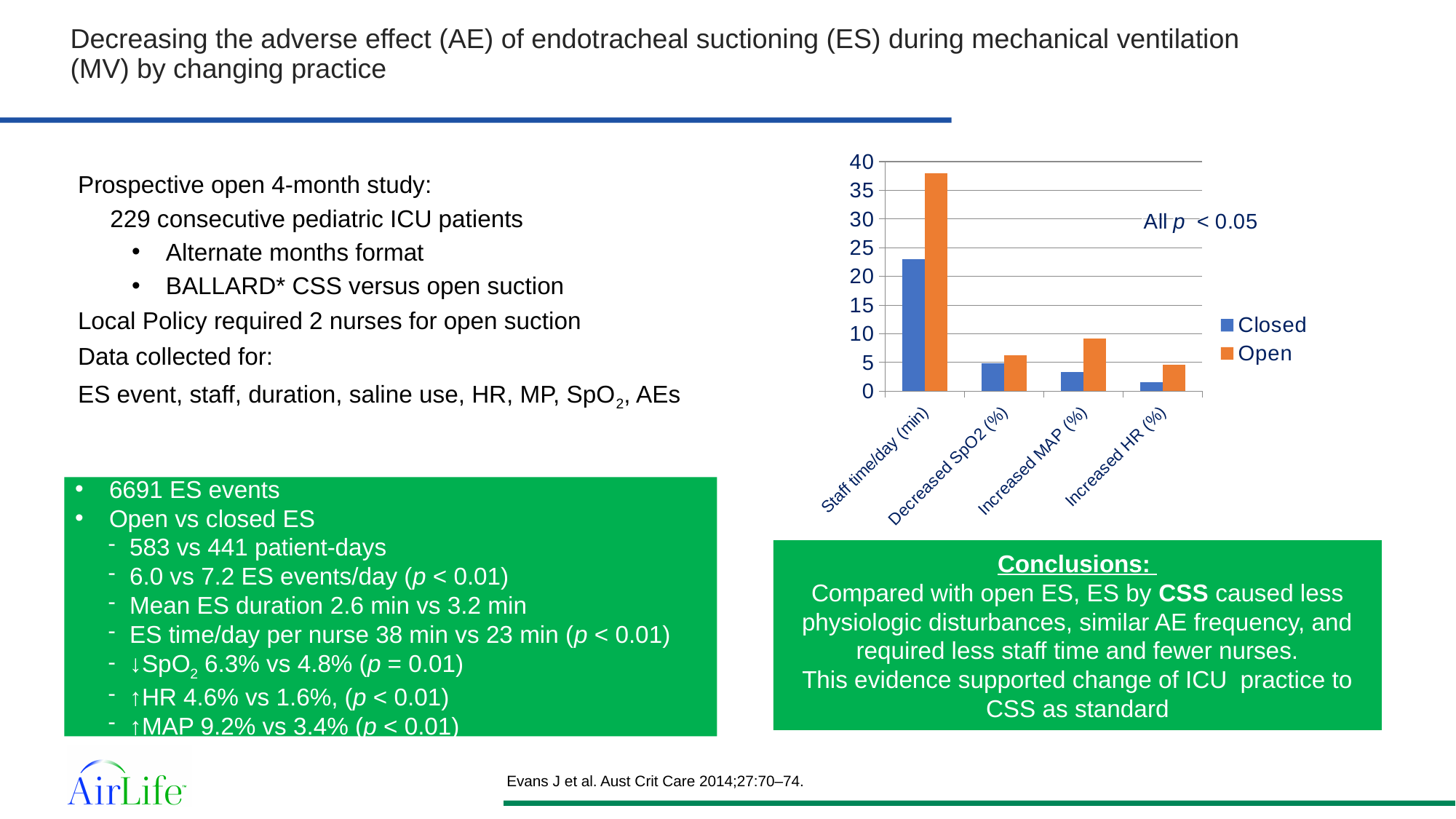
Which category has the highest Open value in the chart? Staff time/day (min) For Increased MAP (%), which series has the larger value, Closed or Open? Open Is the Closed value for Increased HR (%) greater or less than 5? less How many categories are shown on the x axis of the chart? 4 Which series is shown in orange in the chart? Open Which category has the lowest Closed value in the chart? Increased HR (%) What kind of chart is shown on the slide? bar chart Is the Open value for Increased MAP (%) greater or less than 10? less What annotation about statistical significance is printed inside the chart area? All p < 0.05 How many series does the chart legend list? 2 Is the Open value for Staff time/day (min) greater or less than 35? greater